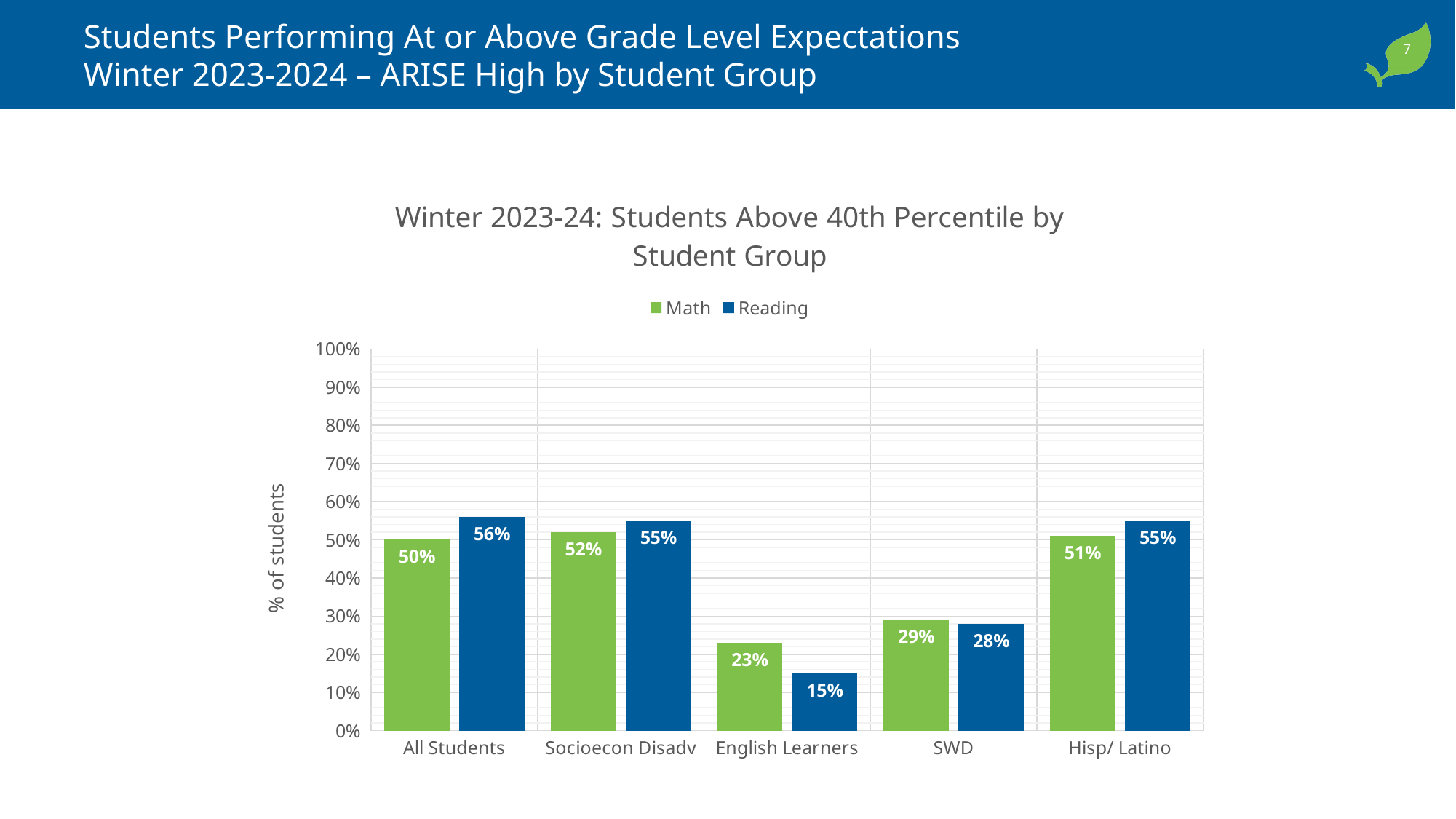
What is the Reading value for All Students? 56% Is the Reading value for Hisp/ Latino greater or less than 40%? greater Which is larger for Socioecon Disadv, the Math value or the Reading value? Reading What is the difference between the Math and Reading values for English Learners? 8% How many student groups are shown on the x axis? 5 Which student group has the lowest Math value? English Learners What kind of chart is shown on the slide? Bar chart What is the Math value for English Learners? 23% How many series does the legend list? 2 What is the Reading value for SWD? 28% Which student group has the highest Reading value? All Students What is the label on the vertical axis? % of students